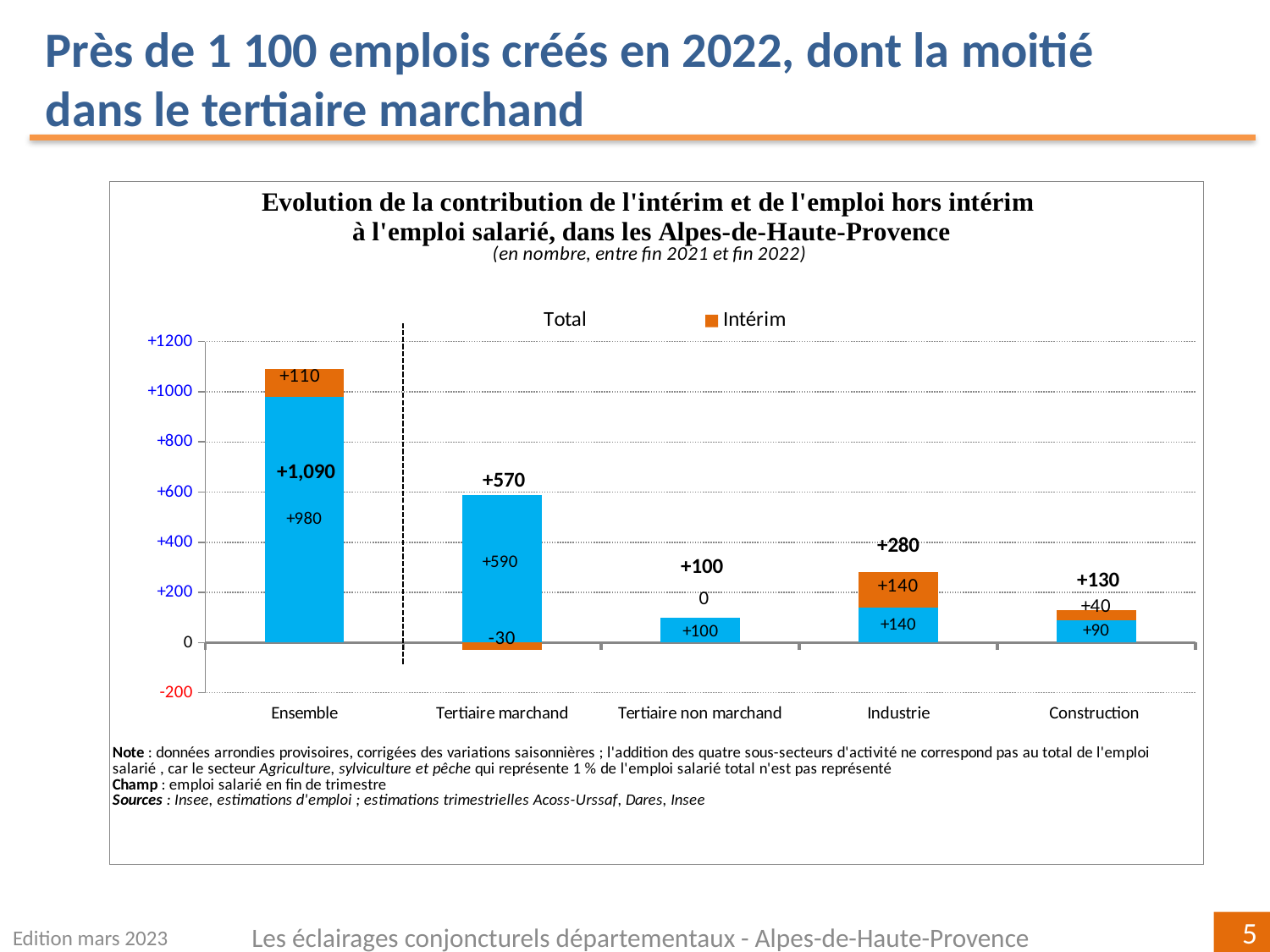
Which category has the highest total? Ensemble Which category has the lowest total? Tertiaire non marchand What is the Intérim value for Industrie? +140 Which has the larger Intérim value, Industrie or Construction? Industrie What total is labelled above the Construction bar? +130 How many categories are shown on the x axis? 5 What is the value of the blue segment for Tertiaire non marchand? +100 What kind of chart is this? Stacked bar chart What is the Intérim value for Ensemble? +110 What is the difference between the totals for Tertiaire marchand and Industrie? 290 What is the total for Ensemble? +1,090 What is the Intérim value for Tertiaire marchand? -30